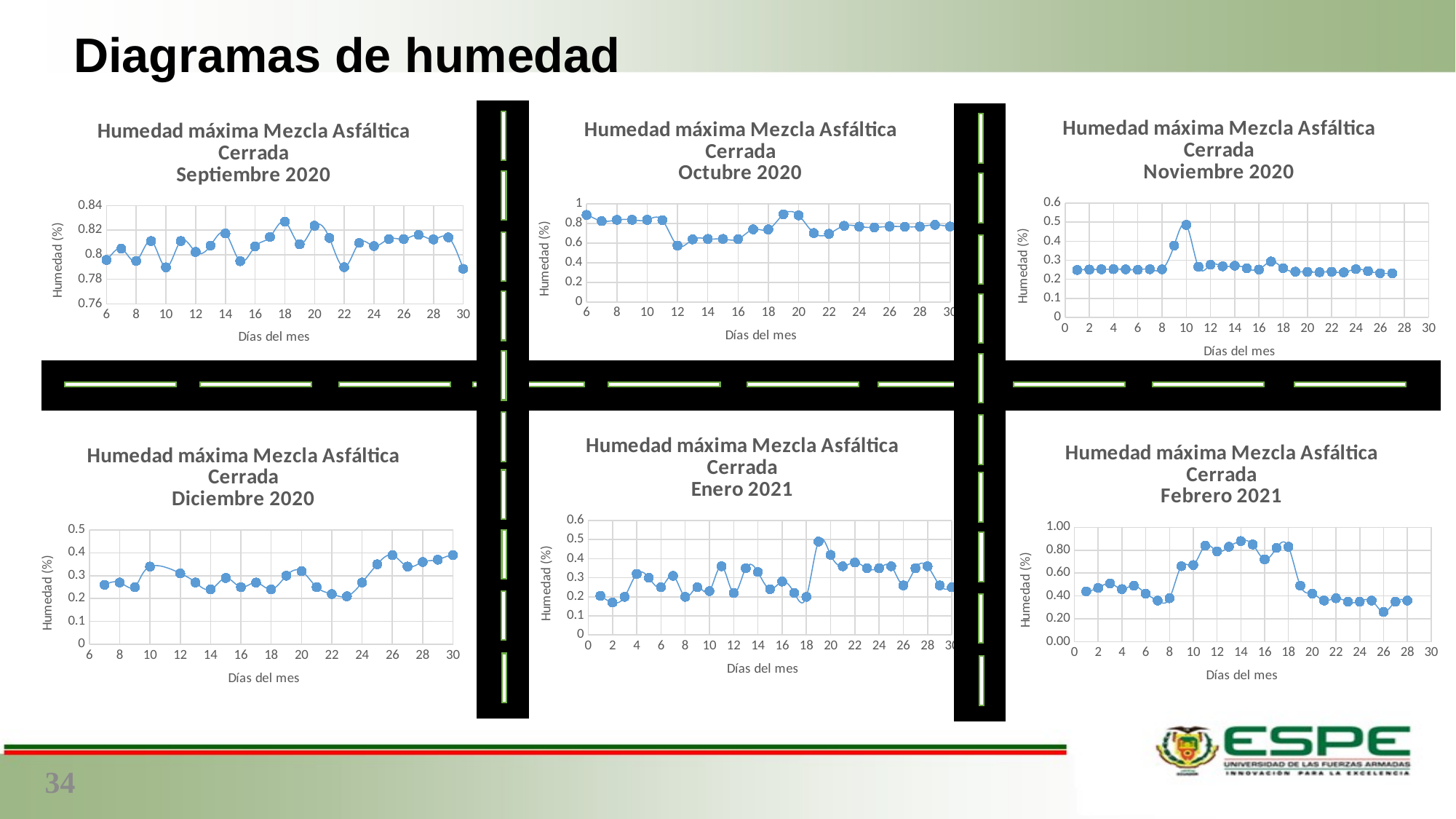
In the Septiembre 2020 chart, is the value for day 22 greater or less than 0.8? less In the Noviembre 2020 chart, is the value for day 10 greater or less than 0.4? greater What is the x-axis title of the Diciembre 2020 chart? Días del mes In the Noviembre 2020 chart, which day of the month has the highest humidity value? 10 In the Febrero 2021 chart, do the values rise or fall between day 18 and day 26? fall How many charts are shown on the slide? 6 In the Febrero 2021 chart, which day of the month has the lowest humidity value? 26 In the Enero 2021 chart, which day of the month has the highest humidity value? 19 What kind of chart is the 'Humedad máxima Mezcla Asfáltica Cerrada Septiembre 2020' chart? line chart In the Diciembre 2020 chart, is the value for day 23 greater or less than 0.3? less